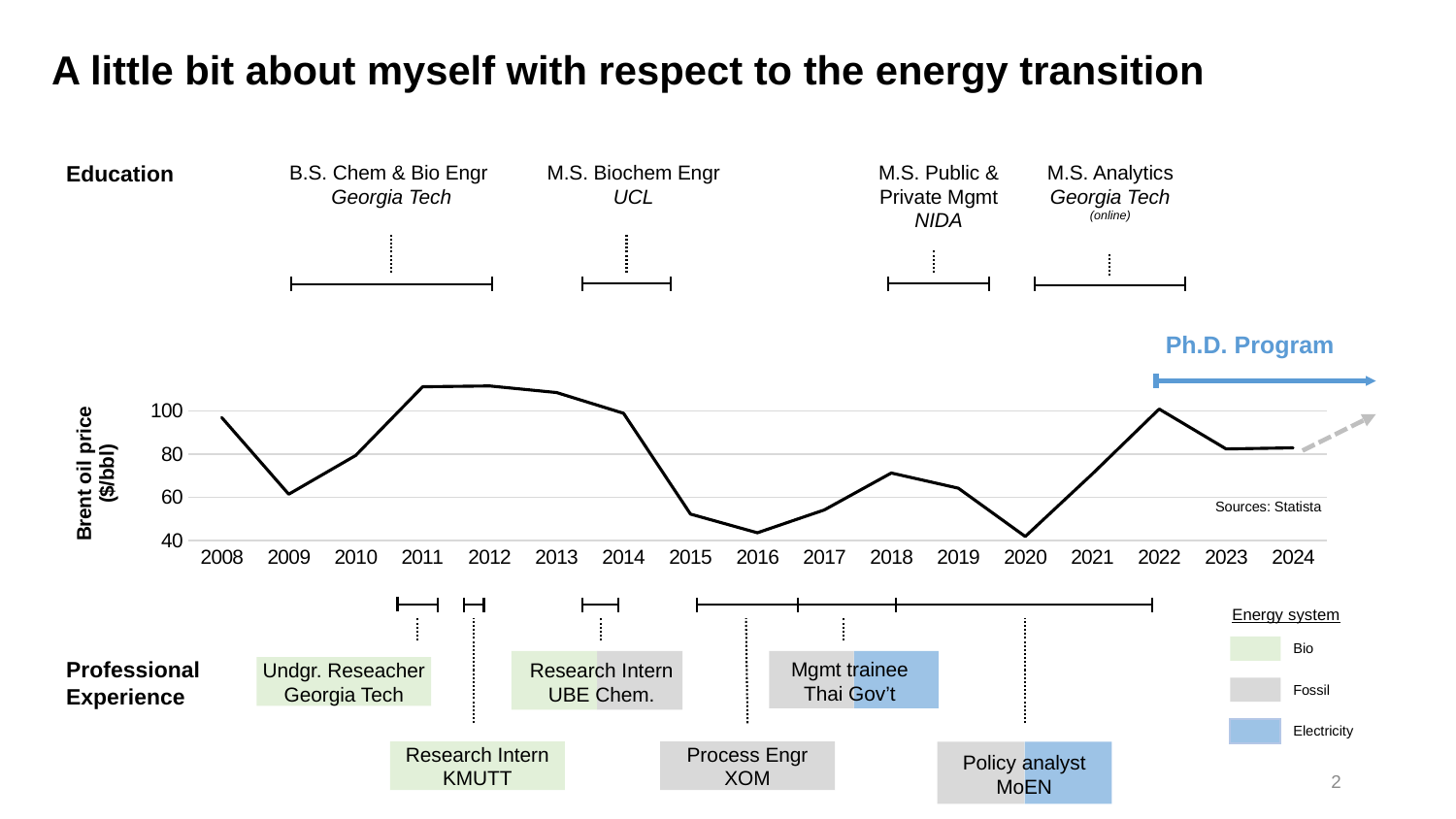
Is the Brent oil price value for 2009 greater or less than 80? less Does the Brent oil price rise or fall between 2012 and 2016? fall How many years are labelled on the x axis of the Brent oil price chart? 17 What source is cited for the Brent oil price chart? Statista Which year has the higher Brent oil price, 2011 or 2016? 2011 Is the Brent oil price value for 2011 greater or less than 100? greater Does the Brent oil price rise or fall between 2020 and 2022? rise What kind of chart is used to show the Brent oil price on the slide? line chart Is the Brent oil price value for 2020 greater or less than 60? less Which year has the higher Brent oil price, 2018 or 2020? 2018